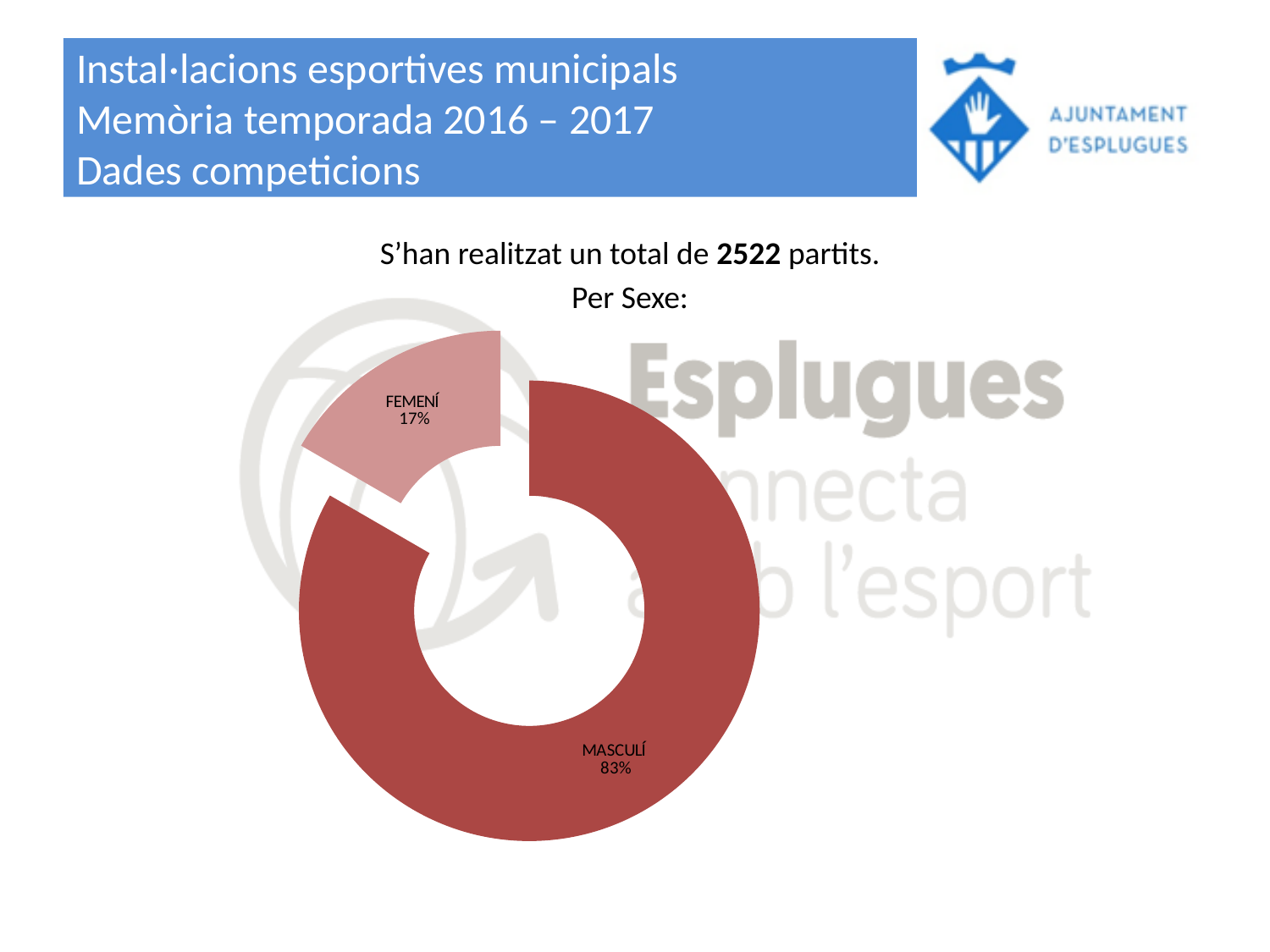
What share of the matches were played by the FEMENÍ category? 17% Which is larger, the share for MASCULÍ or the share for FEMENÍ? MASCULÍ What is the difference in percentage points between the MASCULÍ and FEMENÍ shares? 66 How many categories are shown in the chart? 2 Which category has the largest share of the chart? MASCULÍ What is the total number of matches stated on the slide? 2522 Which category has the smallest share of the chart? FEMENÍ What kind of chart is shown on the slide? Doughnut chart Which category is shown in the lighter pink colour? FEMENÍ What share of the matches were played by the MASCULÍ category? 83%